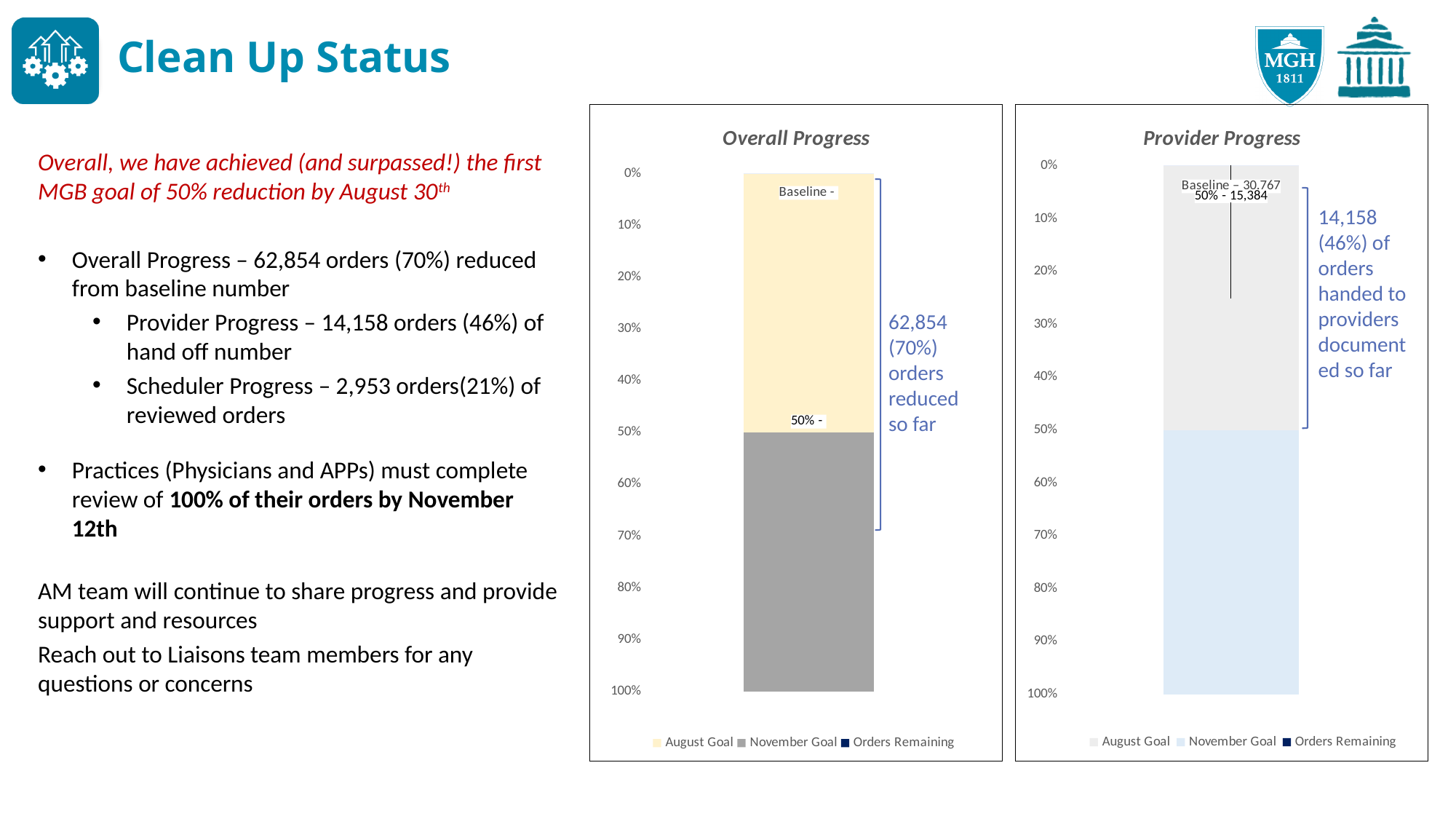
In the Overall Progress chart, what percentage of orders does the annotation say have been reduced so far? 70% What is the title of the chart on the left? Overall Progress What kind of chart is the Overall Progress chart? Stacked bar chart What is the title of the chart on the right? Provider Progress In the Overall Progress chart, how many series does the legend list? 3 In the Provider Progress chart, what value is labelled as 50% on the bar? 15,384 In the Provider Progress chart, what is the baseline number shown on the bar? 30,767 In the Provider Progress chart, how many series does the legend list? 3 What kind of chart is the Provider Progress chart? Stacked bar chart In the Overall Progress chart, how many orders does the annotation say have been reduced so far? 62,854 In the Provider Progress chart, what percentage of orders does the annotation say have been documented so far? 46% In the Provider Progress chart, how many orders does the annotation say have been documented so far? 14,158